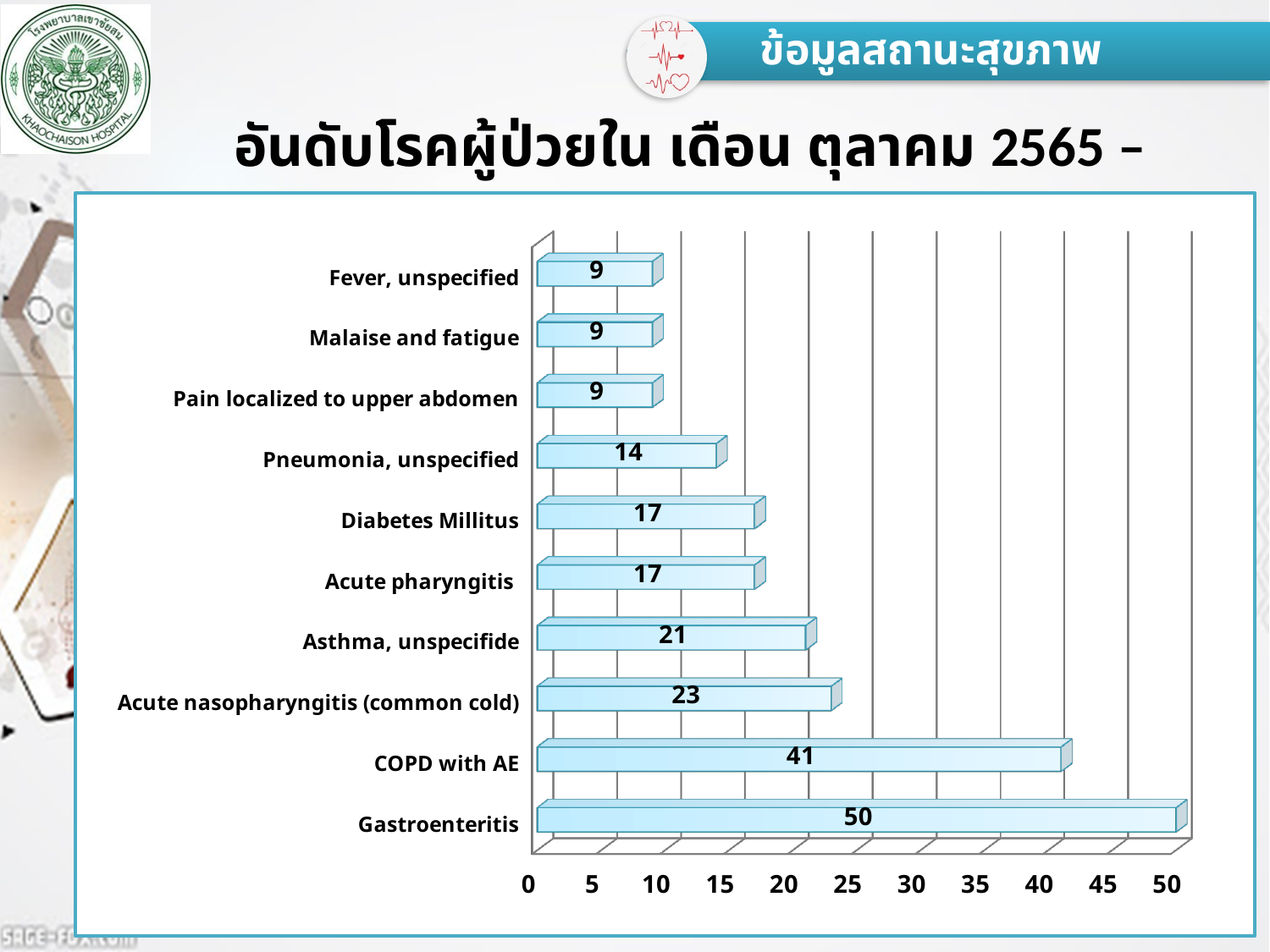
What is the value for COPD with AE? 41 What is the value for Pneumonia, unspecified? 14 What is the maximum value shown on the horizontal axis? 50 How many categories are shown in the chart? 10 What is the difference between the values for Acute nasopharyngitis (common cold) and Asthma, unspecifide? 2 What kind of chart is shown on the slide? bar chart What is the value for Asthma, unspecifide? 21 What is the difference between the values for Gastroenteritis and COPD with AE? 9 Is the value for Diabetes Millitus greater or less than 20? less Which category has the highest value? Gastroenteritis Which is larger, the value for COPD with AE or the value for Acute nasopharyngitis (common cold)? COPD with AE What is the value for Gastroenteritis? 50